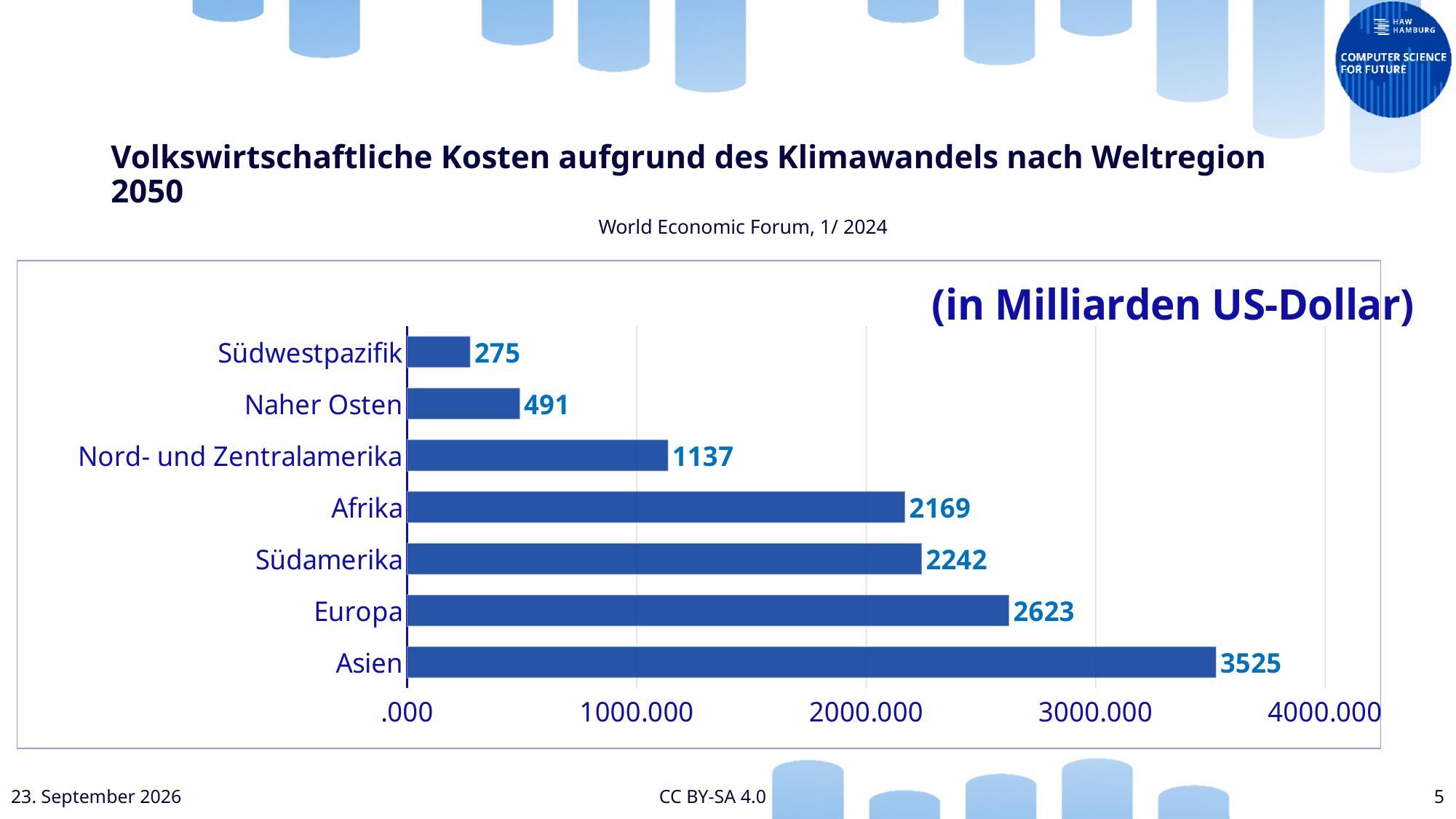
What is the difference between the values for Asien and Südwestpazifik? 3250 What unit is stated for the values in the chart? in Milliarden US-Dollar Which is larger, the value for Naher Osten or the value for Südwestpazifik? Naher Osten Is the value for Europa greater or less than 2000.000? greater Which region has the highest value? Asien What is the value for Nord- und Zentralamerika? 1137 What is the value for Südwestpazifik? 275 What kind of chart is shown on the slide? bar chart Which region has the lowest value? Südwestpazifik What is the value for Asien? 3525 How many regions are shown in the chart? 7 What is the difference between the values for Europa and Afrika? 454